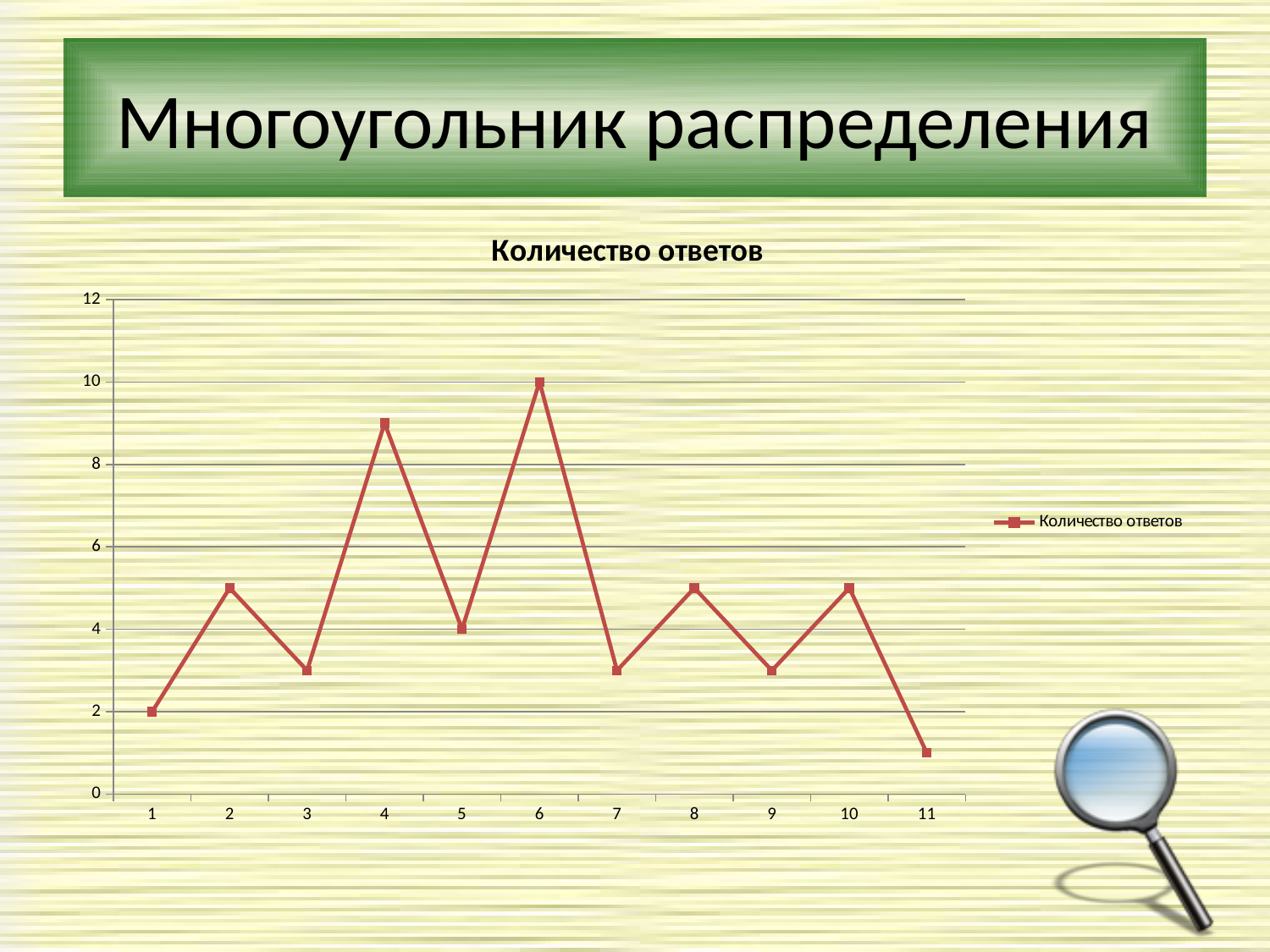
Which category has the highest value? 6 Which category has the lowest value? 11 How many series does the legend list? 1 How many points are plotted along the x axis? 11 What is the difference between the values for category 6 and category 1? 8 What is the value for category 5? 4 Which is larger, the value for category 4 or the value for category 5? category 4 Is the value for category 4 greater or less than 8? greater What is the value for category 6? 10 What is the title of the chart? Количество ответов What type of chart is shown on the slide? line chart What is the value for category 1? 2